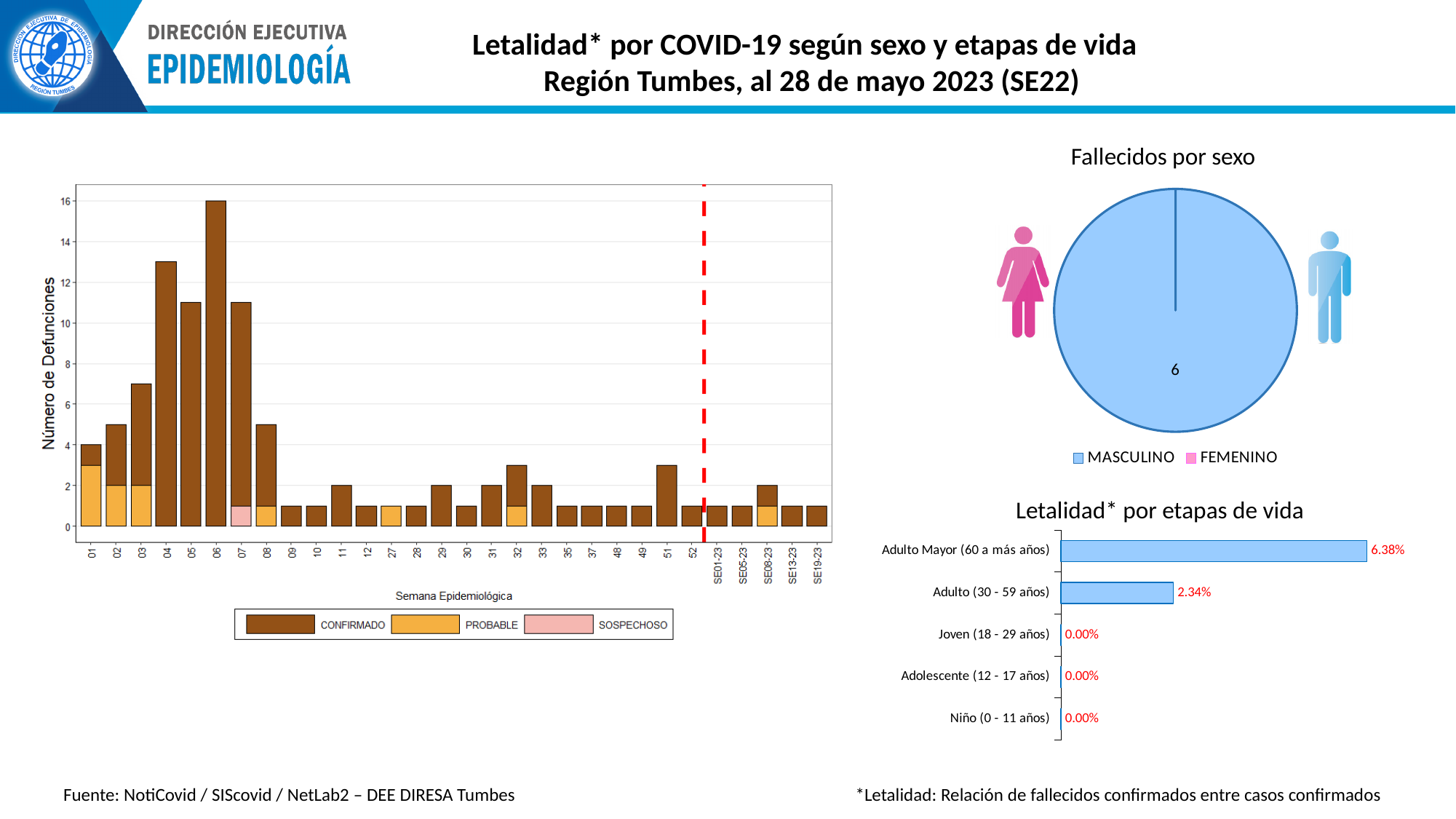
In the 'Letalidad* por etapas de vida' chart, how many age groups are shown? 5 In the 'Letalidad* por etapas de vida' chart, what is the value for Adulto Mayor (60 a más años)? 6.38% In the 'Fallecidos por sexo' pie chart, how many series does the legend list? 2 In the 'Letalidad* por etapas de vida' chart, what is the value for Adulto (30 - 59 años)? 2.34% In the 'Letalidad* por etapas de vida' chart, what is the difference between the values for Adulto Mayor (60 a más años) and Adulto (30 - 59 años)? 4.04% In the 'Letalidad* por etapas de vida' chart, which age group has the highest value? Adulto Mayor (60 a más años) In the 'Número de Defunciones' bar chart on the left, how many series does the legend list? 3 In the 'Número de Defunciones' bar chart on the left, is the value for week 04 greater or less than 12? greater What kind of chart is 'Letalidad* por etapas de vida'? Bar chart In the 'Fallecidos por sexo' pie chart, which sex has the larger share? MASCULINO In the 'Fallecidos por sexo' pie chart, what value is shown for MASCULINO? 6 In the 'Número de Defunciones' bar chart on the left, which epidemiological week has the highest number of deaths? 06